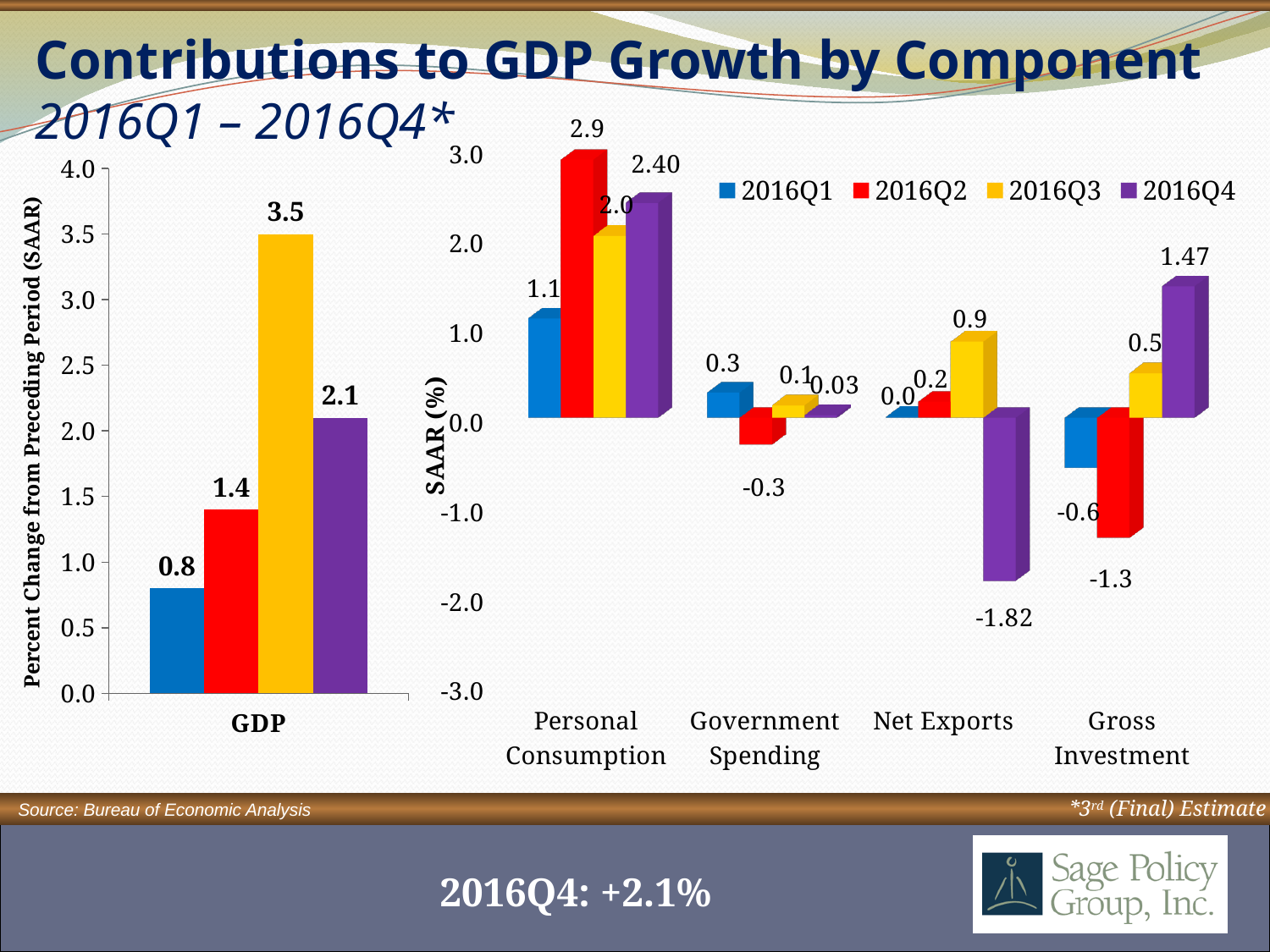
In the right chart, which is larger for Government Spending: the 2016Q1 value or the 2016Q3 value? 2016Q1 In the left chart (GDP), what is the value for 2016Q3? 3.5 In the right chart, which component has the highest value in 2016Q3? Personal Consumption How many component categories are shown on the x axis of the right chart? 4 In the right chart, what is the value for Net Exports in 2016Q4? -1.82 In the left chart (GDP), what is the difference between the 2016Q3 and 2016Q4 values? 1.4 What kind of chart is the left chart (GDP)? bar chart In the right chart, what is the value for Gross Investment in 2016Q4? 1.47 In the right chart, what is the difference between the Gross Investment values for 2016Q1 and 2016Q2? 0.7 In the left chart (GDP), which quarter has the lowest value? 2016Q1 In the right chart, what is the value for Personal Consumption in 2016Q2? 2.9 How many series does the legend of the right chart list? 4